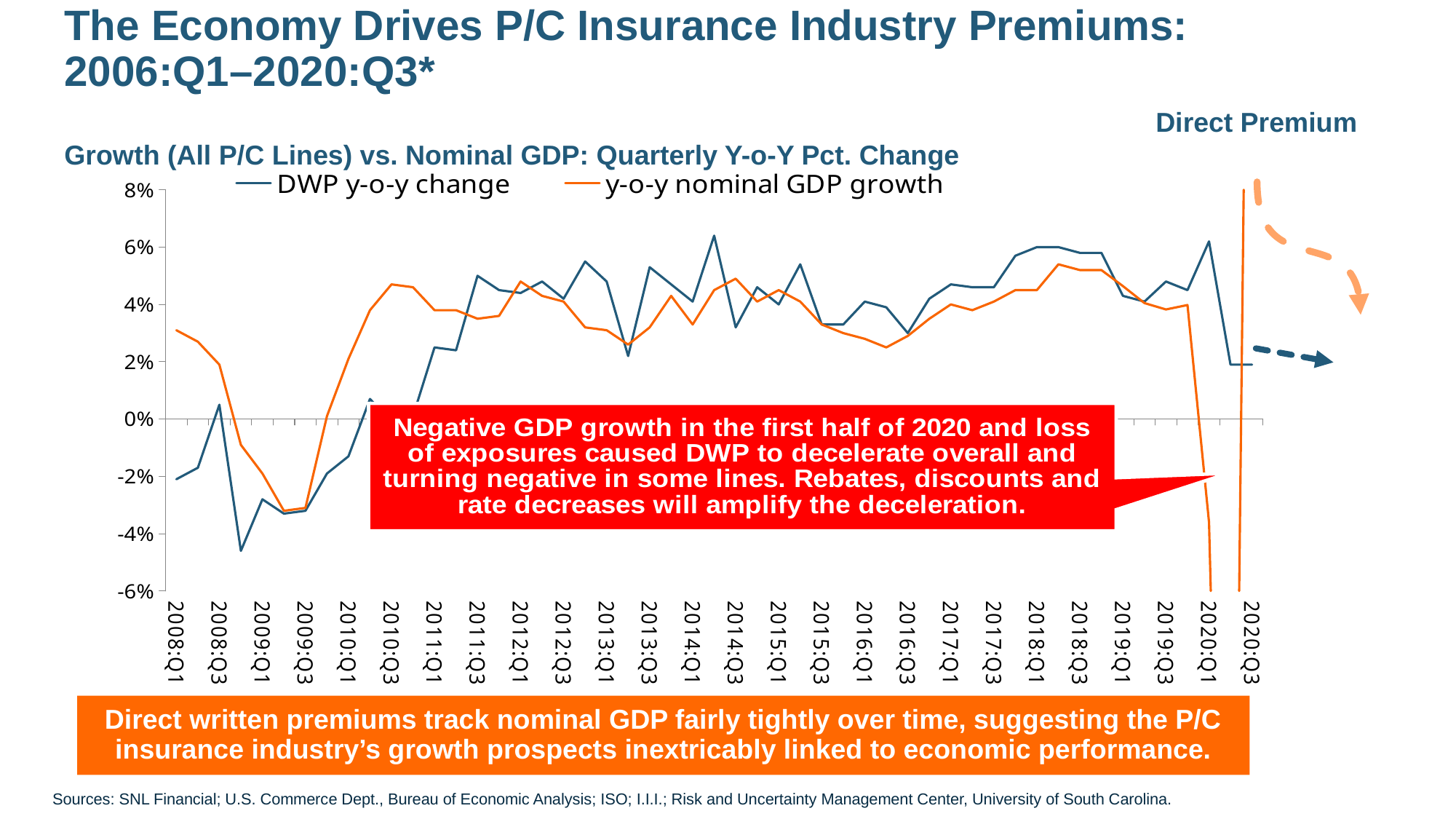
Is the DWP y-o-y change value at 2020:Q3 greater or less than 4%? less Which series is drawn in orange? y-o-y nominal GDP growth How many series does the chart legend list? 2 Which series reaches the lower value during the 2008-2009 downturn, DWP y-o-y change or y-o-y nominal GDP growth? DWP y-o-y change Is the y-o-y nominal GDP growth value at 2018:Q3 greater or less than 4%? greater What are the two series named in the chart legend? DWP y-o-y change; y-o-y nominal GDP growth Is the DWP y-o-y change value at 2008:Q1 greater or less than 0%? less What kind of chart is shown on the slide? Line chart What is the highest value shown on the chart's vertical axis? 8% At 2020:Q3, which series shows the higher value, DWP y-o-y change or y-o-y nominal GDP growth? y-o-y nominal GDP growth Does the y-o-y nominal GDP growth line rise or fall between 2009:Q1 and 2010:Q3? Rise